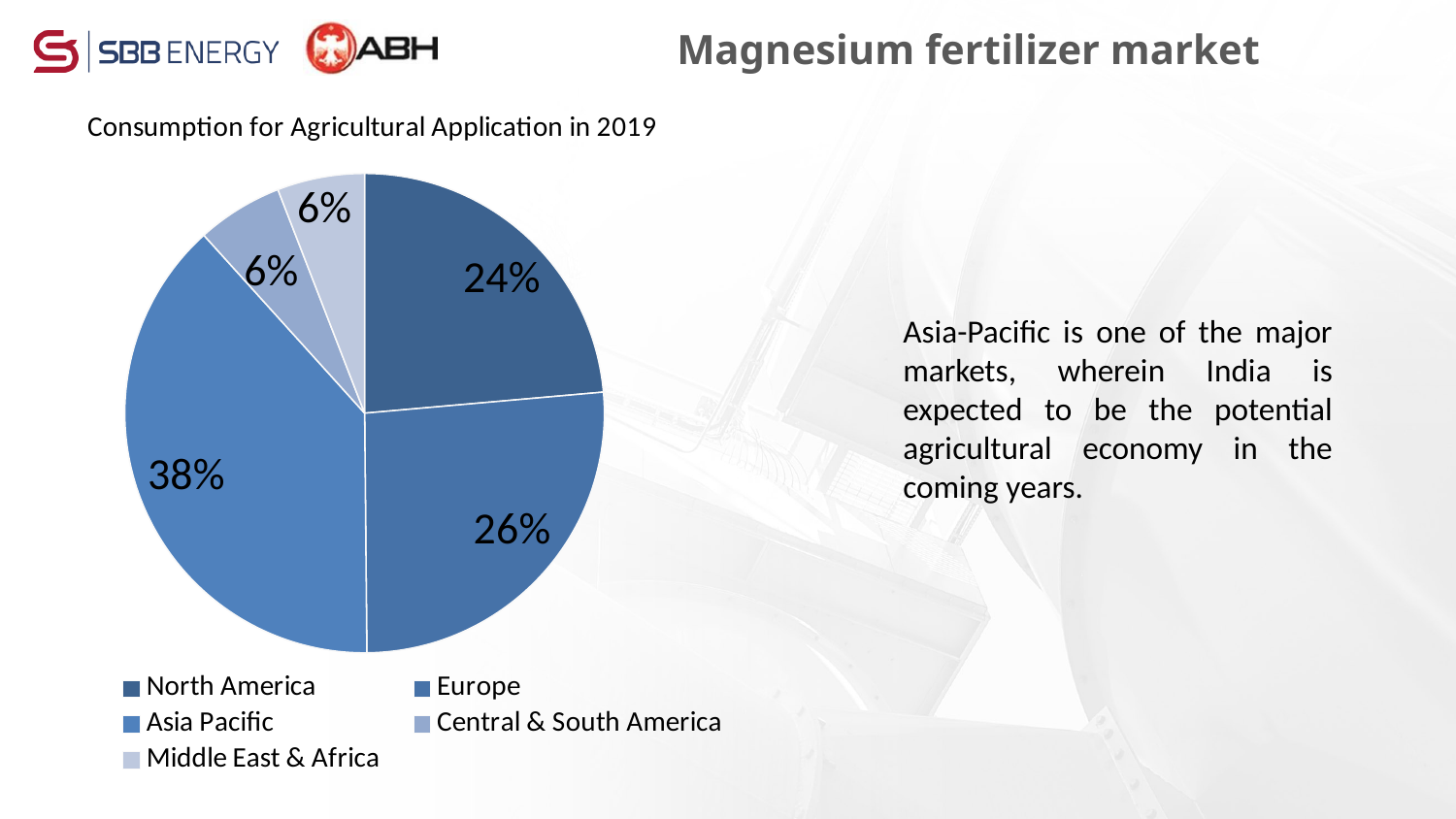
Which two regions share the smallest slice of the pie chart? Central & South America and Middle East & Africa What share does Central & South America have in the pie chart? 6% What is the value for North America in the pie chart? 24% What is the difference in percentage points between Europe and North America? 2 Which is larger, the share for Europe or the share for North America? Europe What share of consumption does Asia Pacific account for in the pie chart? 38% What is the difference in percentage points between Asia Pacific and Europe? 12 What percentage is shown for Europe in the pie chart? 26% How many regions are shown in the pie chart? 5 What is the title of the chart on the slide? Consumption for Agricultural Application in 2019 Which region has the largest slice of the pie chart? Asia Pacific What type of chart is shown on the slide? Pie chart